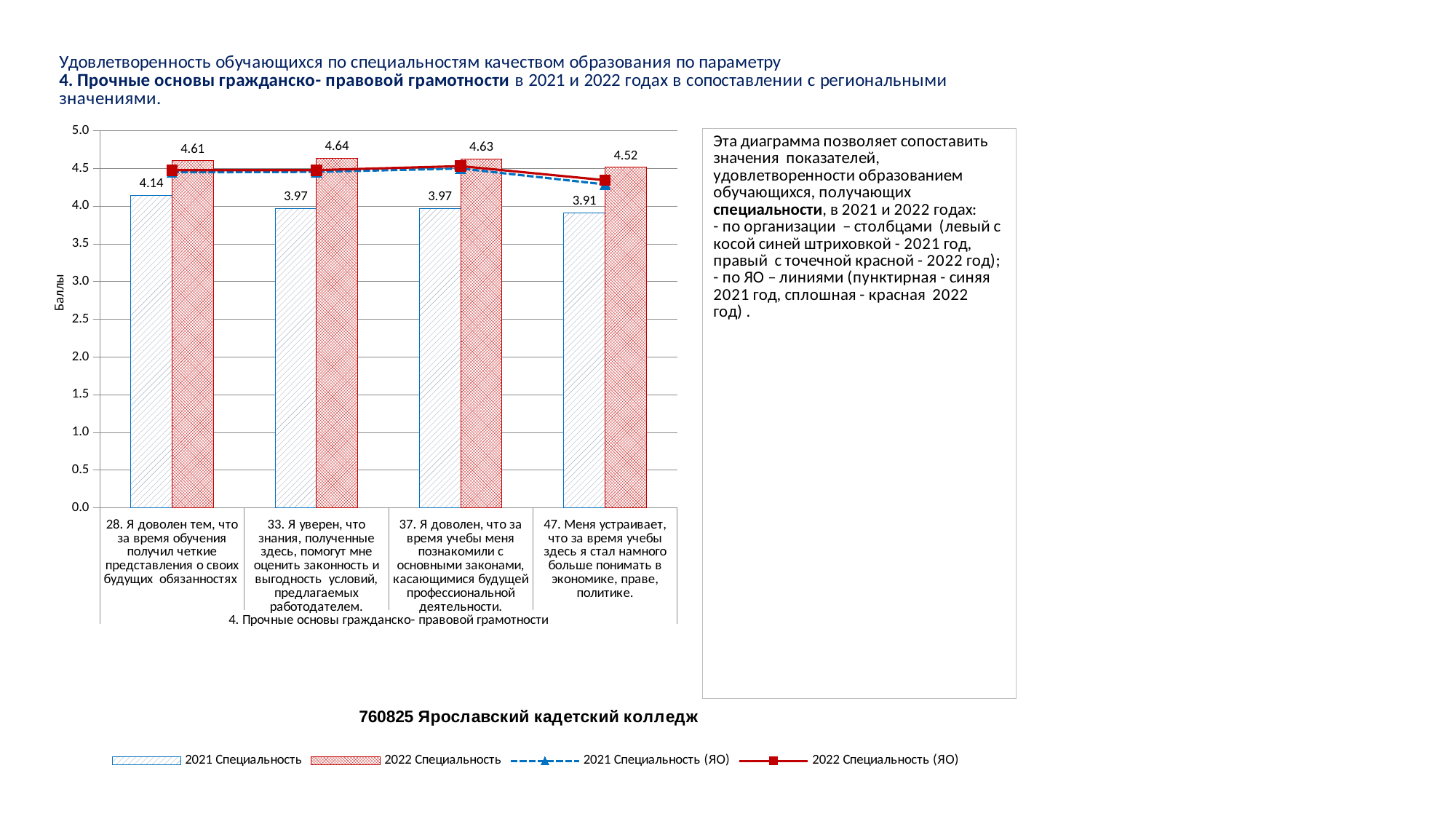
For item 37, which is larger: the 2021 Специальность value or the 2022 Специальность value? 2022 Специальность Is the 2021 Специальность (ЯО) line value for item 28 greater or less than 4.0? greater What is the label of the y axis? Баллы What type of chart is used for the Специальность values for 2021 and 2022? Bar chart Which item has the lowest 2021 Специальность value? 47. Меня устраивает, что за время учебы здесь я стал намного больше понимать в экономике, праве, политике. Which item has the highest 2022 Специальность value? 33. Я уверен, что знания, полученные здесь, помогут мне оценить законность и выгодность условий, предлагаемых работодателем. What is the difference between the 2022 and 2021 Специальность values for item 47? 0.61 What is the 2022 Специальность value for item 28 (Я доволен тем, что за время обучения получил четкие представления о своих будущих обязанностях)? 4.61 What is the 2021 Специальность value for item 47 (Меня устраивает, что за время учебы здесь я стал намного больше понимать в экономике, праве, политике)? 3.91 How many series does the legend list? 4 How many survey items (categories) are shown on the x axis? 4 What is the 2021 Специальность value for item 33 (Я уверен, что знания, полученные здесь, помогут мне оценить законность и выгодность условий, предлагаемых работодателем)? 3.97